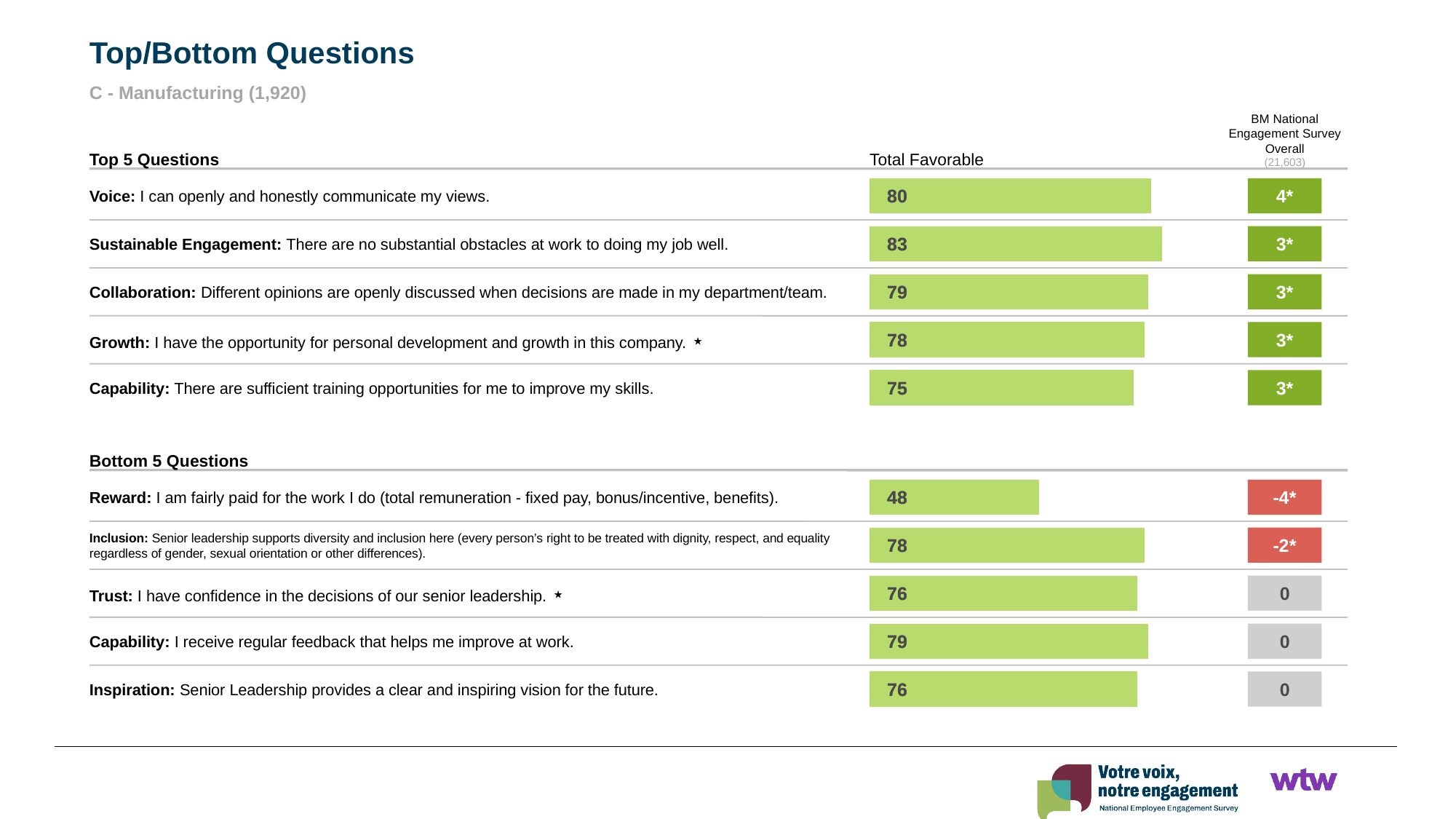
What kind of chart is used to show the Total Favorable values on this slide? Bar chart In the Bottom 5 Questions chart, what is the BM National Engagement Survey Overall difference shown for Inclusion? -2* In the Top 5 Questions chart, what is the BM National Engagement Survey Overall difference shown for Voice? 4* How many questions are listed in the Bottom 5 Questions chart? 5 In the Top 5 Questions chart, what is the Total Favorable value for Sustainable Engagement? 83 In the Top 5 Questions chart, which question has the highest Total Favorable value? Sustainable Engagement In the Bottom 5 Questions chart, which question has the highest Total Favorable value? Capability In the Top 5 Questions chart, what is the difference in Total Favorable between Voice and Growth? 2 In the Bottom 5 Questions chart, what is the difference in Total Favorable between Inclusion and Reward? 30 In the Bottom 5 Questions chart, which question has the lowest Total Favorable value? Reward In the Bottom 5 Questions chart, what is the Total Favorable value for Reward? 48 In the Top 5 Questions chart, what is the Total Favorable value for Capability (sufficient training opportunities)? 75